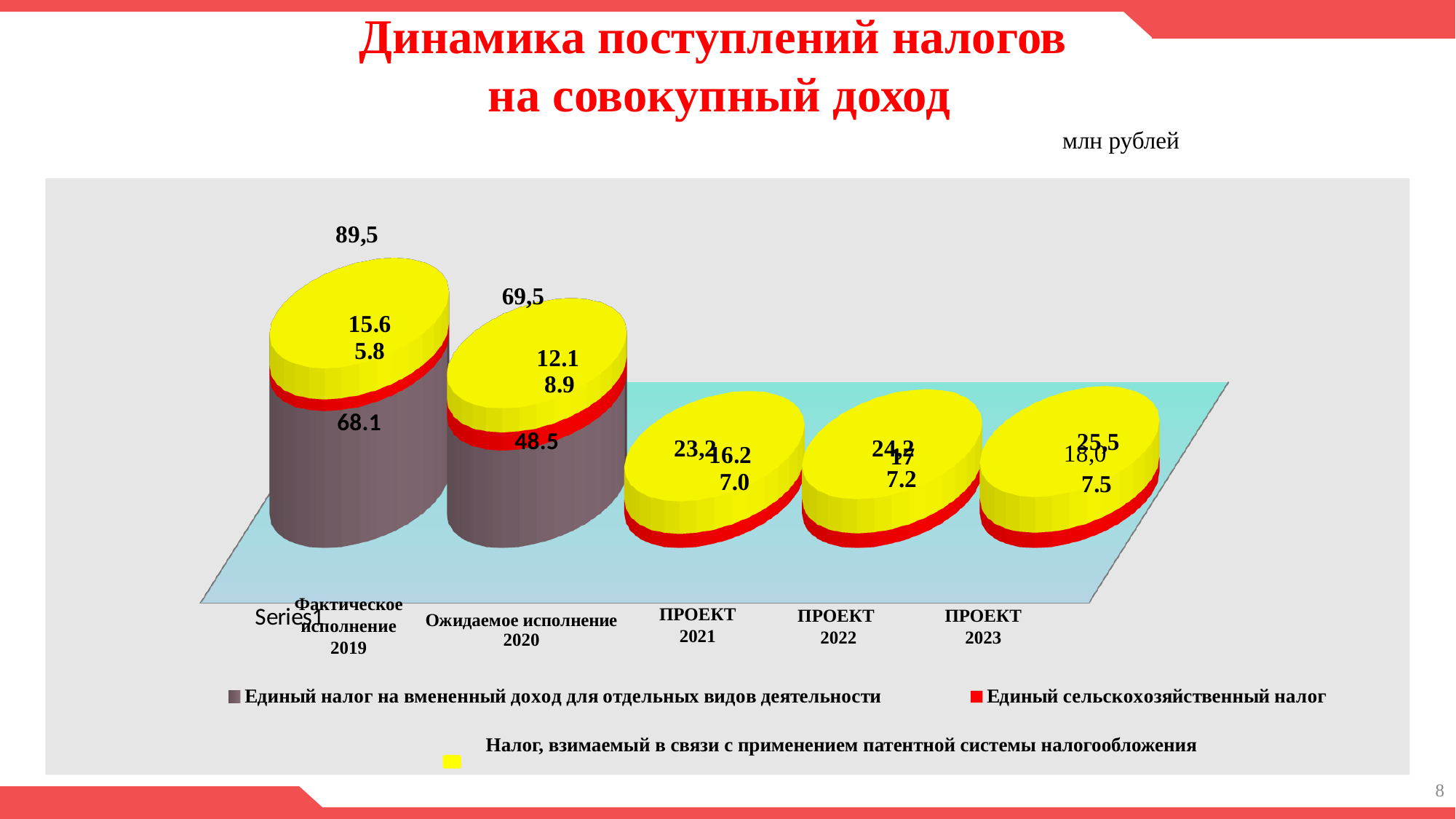
How many series does the legend list? 3 What is the total shown above the bar for ПРОЕКТ 2023? 25,5 What kind of chart is shown on the slide? bar chart Which category has the lowest total? ПРОЕКТ 2021 How many categories are shown along the x axis? 5 What is the value of Налог, взимаемый в связи с применением патентной системы налогообложения for ПРОЕКТ 2021? 16.2 What is the difference between the Единый налог на вмененный доход values for Фактическое исполнение 2019 and Ожидаемое исполнение 2020? 19.6 What is the total shown above the bar for Фактическое исполнение 2019? 89,5 Which is larger: the Единый сельскохозяйственный налог value for ПРОЕКТ 2022 or for ПРОЕКТ 2023? ПРОЕКТ 2023 What is the value of Единый сельскохозяйственный налог for Ожидаемое исполнение 2020? 8.9 What is the value of Единый налог на вмененный доход для отдельных видов деятельности for Фактическое исполнение 2019? 68.1 Which category has the highest total? Фактическое исполнение 2019